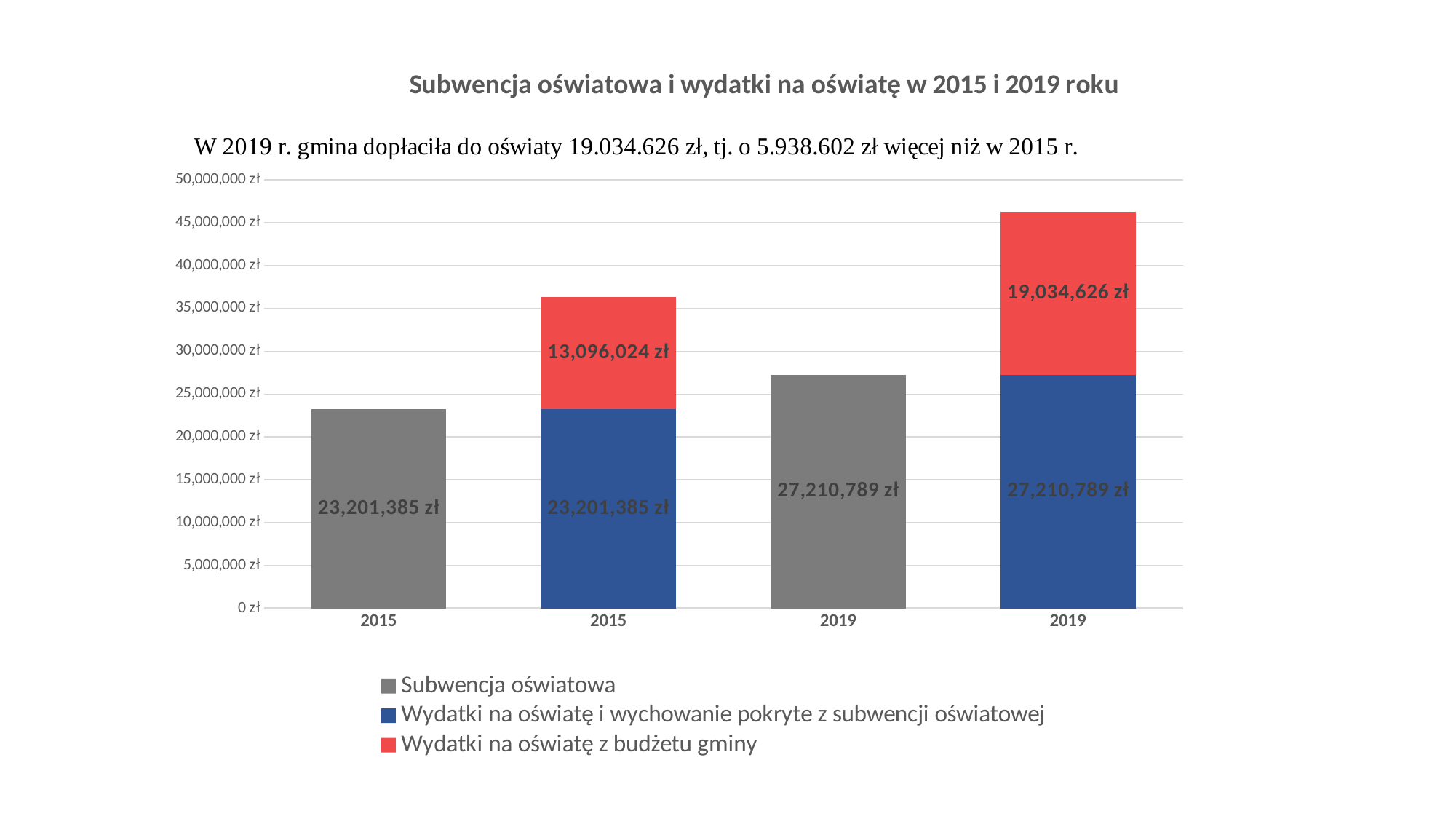
What is the value of the Wydatki na oświatę z budżetu gminy segment in the 2019 stacked bar? 19,034,626 zł How many series does the legend list? 3 How many bars are plotted in the chart? 4 What is the total of the 2019 stacked bar (blue plus red segments)? 46,245,415 zł What is the difference between the Subwencja oświatowa values for 2019 and 2015? 4,009,404 zł What is the total of the 2015 stacked bar (blue plus red segments)? 36,297,409 zł What is the value of the Subwencja oświatowa bar for 2015? 23,201,385 zł What is the value of the Wydatki na oświatę z budżetu gminy segment in the 2015 stacked bar? 13,096,024 zł Which year has the larger Wydatki na oświatę z budżetu gminy segment, 2015 or 2019? 2019 How much larger is the Wydatki na oświatę z budżetu gminy segment in 2019 than in 2015? 5,938,602 zł What is the value of the Subwencja oświatowa bar for 2019? 27,210,789 zł What type of chart is shown on the slide? Stacked bar chart